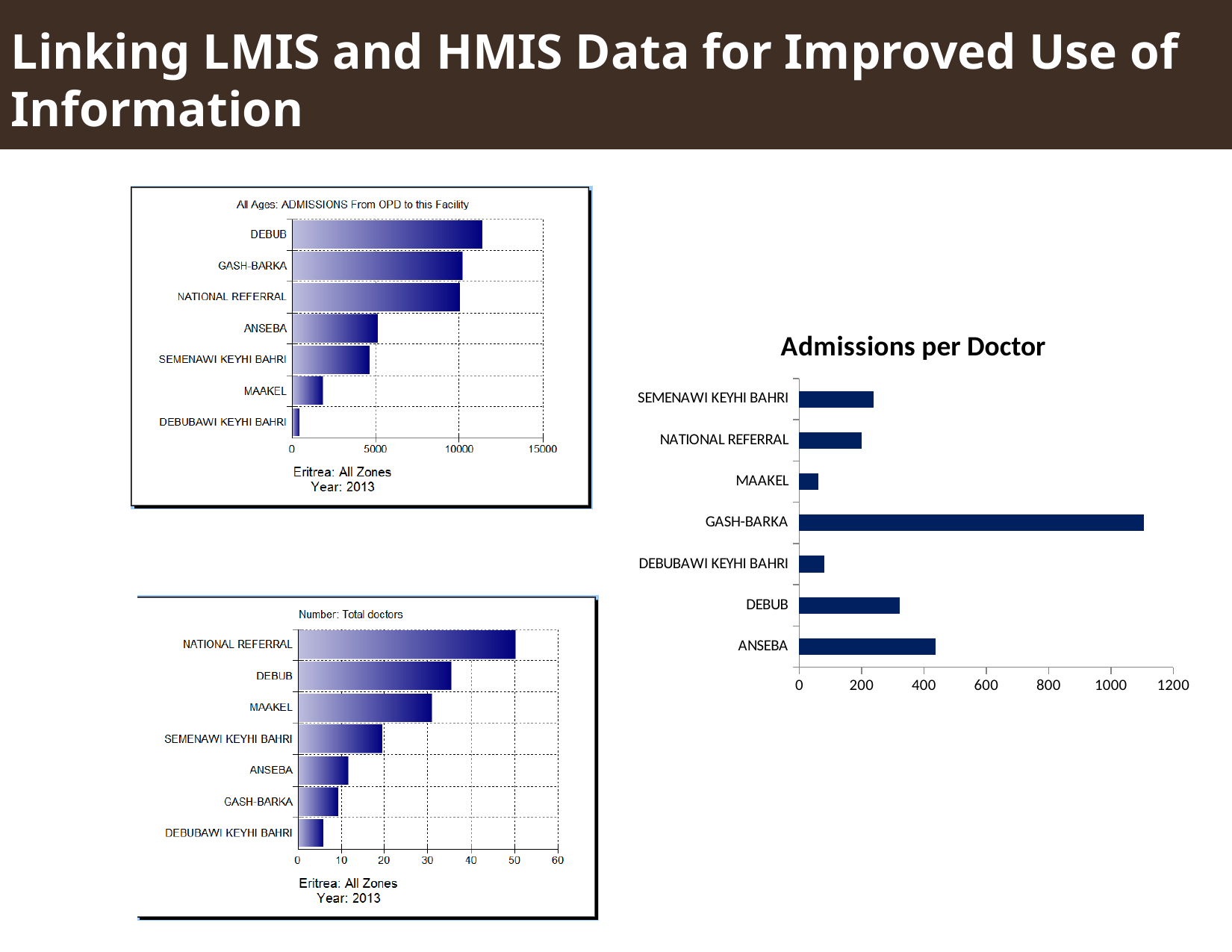
In the 'Admissions per Doctor' chart, which zone has the highest value? GASH-BARKA In the 'Admissions per Doctor' chart, is the value for GASH-BARKA greater or less than 1000? greater What kind of chart is the 'Admissions per Doctor' chart? Bar chart How many zones are shown in the 'Admissions per Doctor' chart? 7 In the 'Admissions per Doctor' chart, is the value for ANSEBA greater or less than 400? greater In the 'Number: Total doctors' chart, which is larger, the value for SEMENAWI KEYHI BAHRI or the value for ANSEBA? SEMENAWI KEYHI BAHRI In the 'Admissions per Doctor' chart, which is larger, the value for DEBUB or the value for NATIONAL REFERRAL? DEBUB In the 'All Ages: ADMISSIONS From OPD to this Facility' chart, which zone has the highest value? DEBUB In the 'Number: Total doctors' chart, which zone has the highest value? NATIONAL REFERRAL In the 'Number: Total doctors' chart, is the value for MAAKEL greater or less than 20? greater In the 'All Ages: ADMISSIONS From OPD to this Facility' chart, which zone has the lowest value? DEBUBAWI KEYHI BAHRI